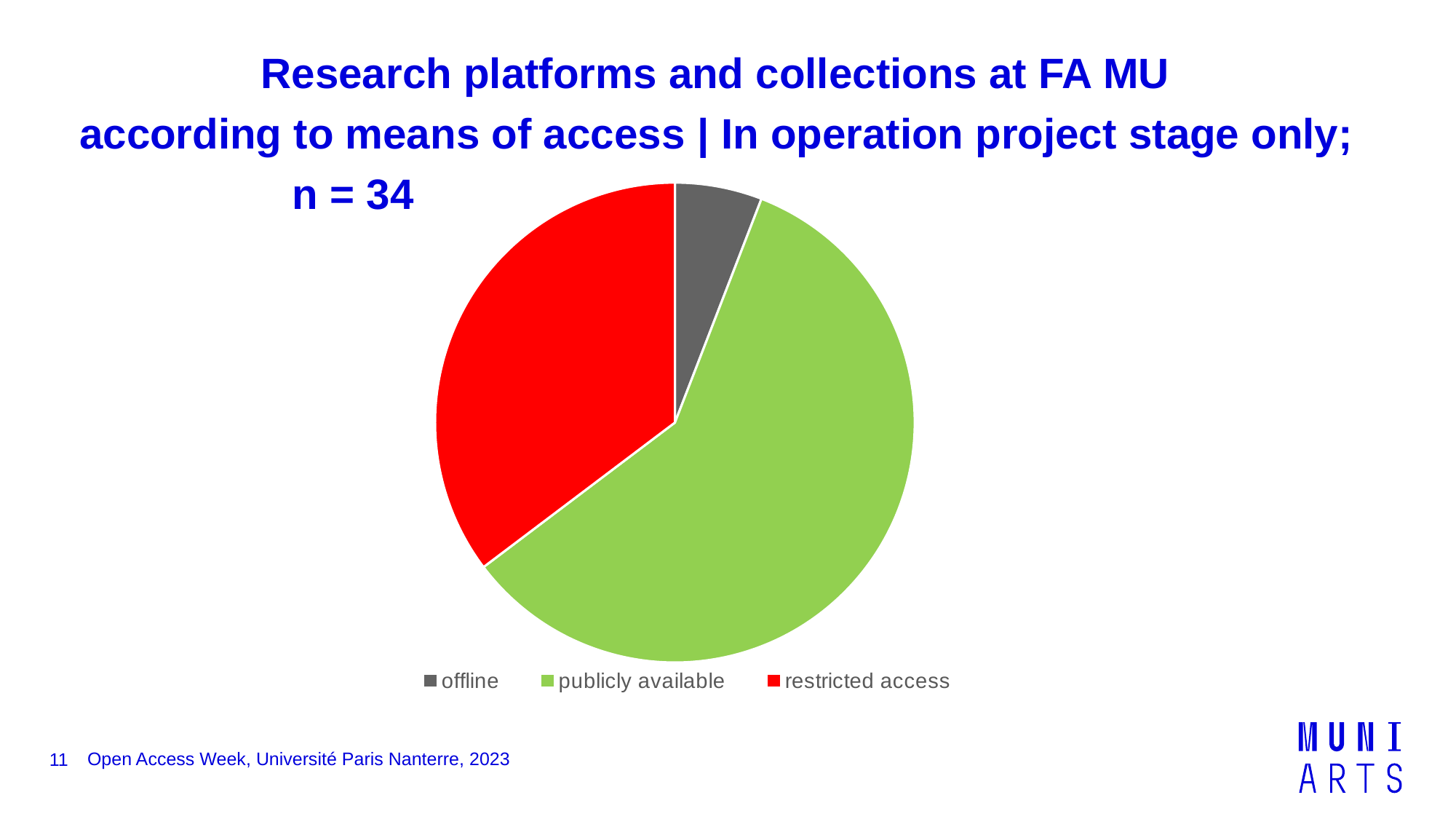
How many slices does the pie chart have? 3 Which category has the largest slice of the pie chart? publicly available Which slice is larger, publicly available or restricted access? publicly available Which category is shown in red in the pie chart? restricted access What kind of chart is shown on the slide? pie chart Which slice is larger, restricted access or offline? restricted access Which category has the smallest slice of the pie chart? offline What is the sample size (n) stated in the chart title? 34 How many entries does the legend of the pie chart list? 3